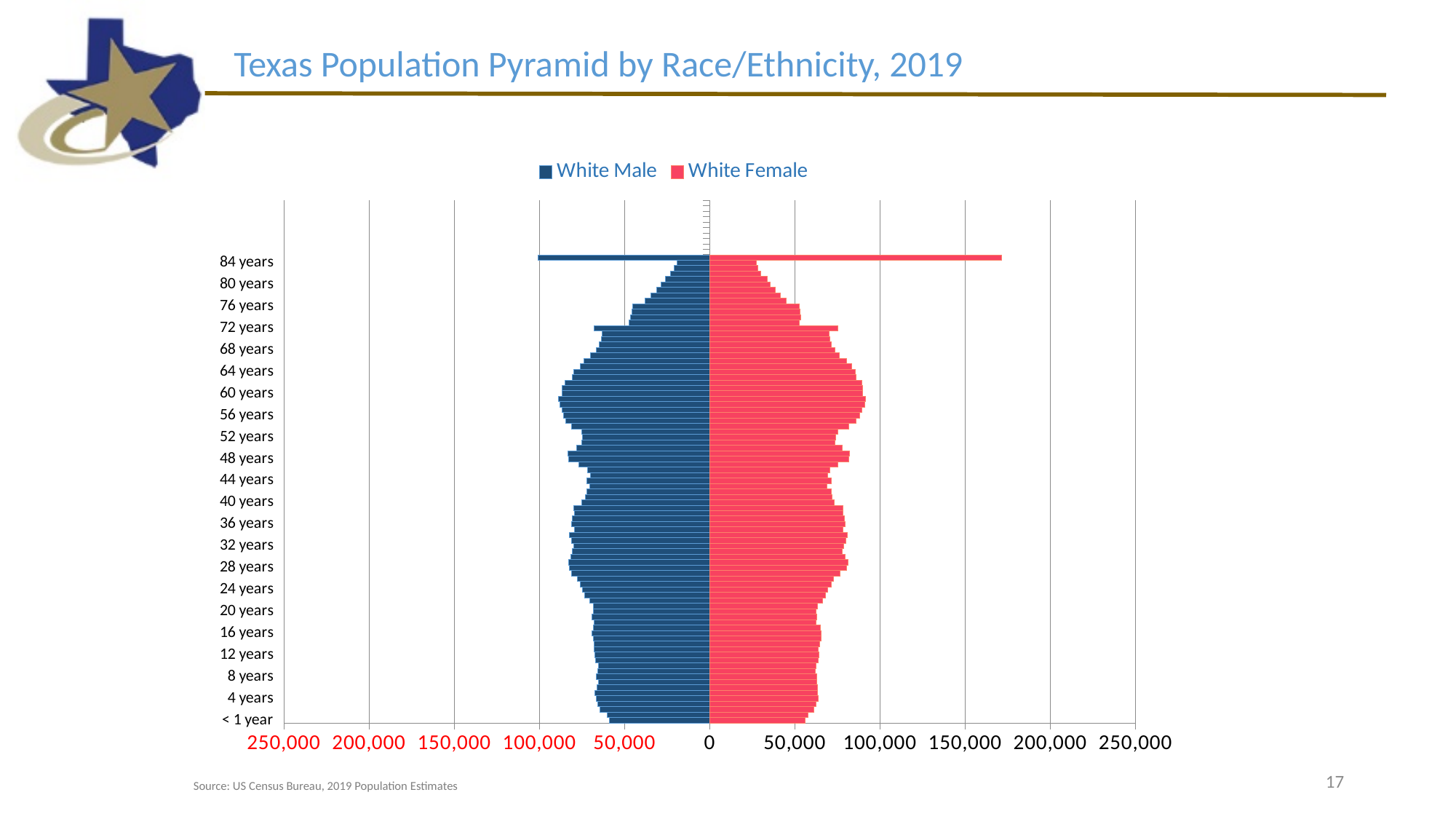
At 84 years, which is larger: the White Male value or the White Female value? White Female Is the White Female value for 60 years greater or less than 100,000? less How many series does the legend list? 2 Is the White Male value for 60 years greater or less than 50,000? greater What kind of chart is shown on the slide? Bar chart (population pyramid) How many age labels are shown on the vertical axis? 22 Is the White Male value for < 1 year greater or less than 100,000? less Which colour represents White Female in the chart? Pink/red What is the title of the chart on the slide? Texas Population Pyramid by Race/Ethnicity, 2019